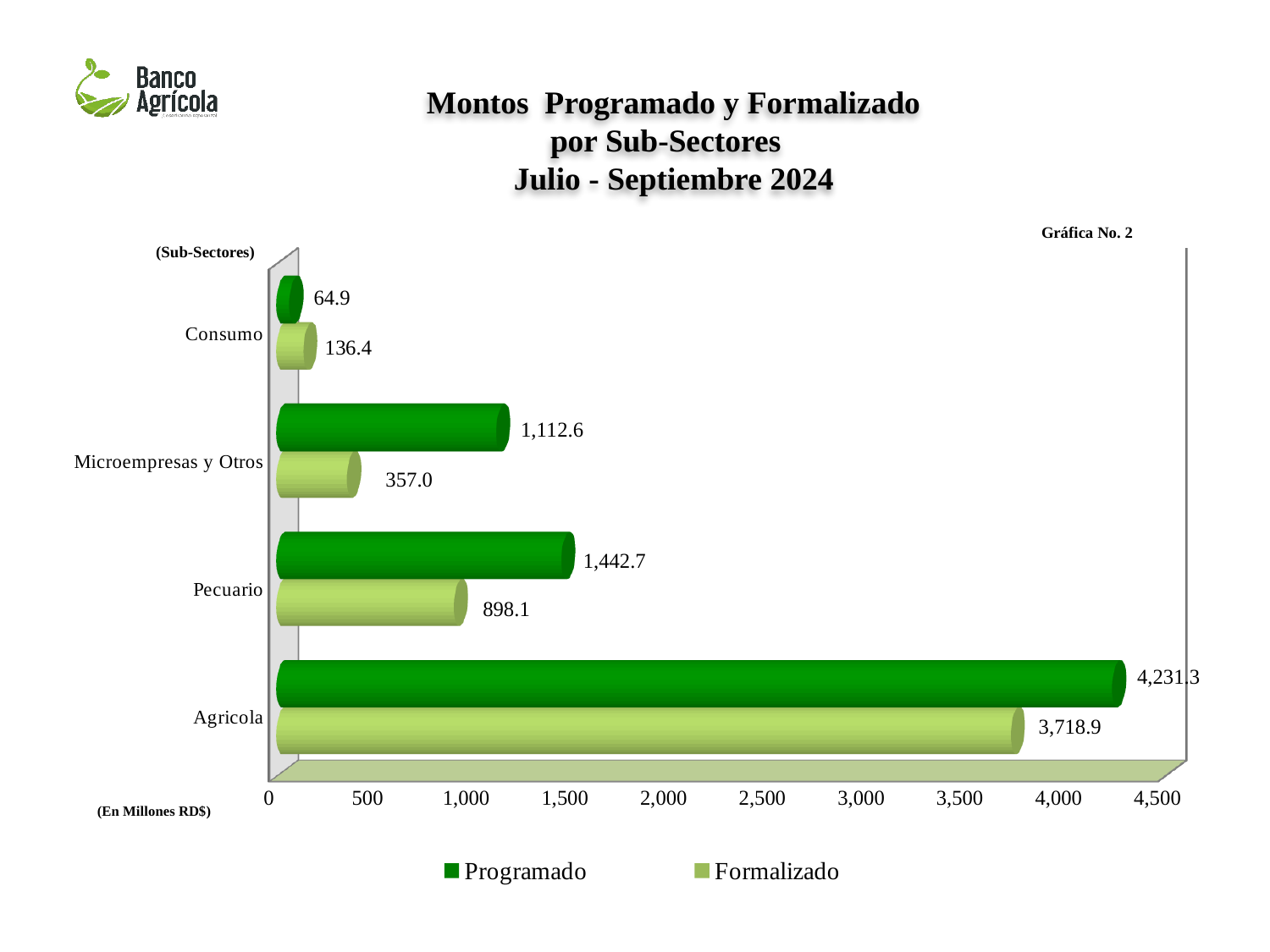
What is the Formalizado value for Microempresas y Otros? 357.0 What is the Formalizado value for Pecuario? 898.1 What is the Programado value for Consumo? 64.9 For Consumo, which is larger: the Programado value or the Formalizado value? Formalizado How many sub-sectors are shown on the chart? 4 What is the difference between the Programado and Formalizado values for Agricola? 512.4 What is the difference between the Programado and Formalizado values for Microempresas y Otros? 755.6 Which sub-sector has the highest Programado value? Agricola How many series does the legend list? 2 What kind of chart is shown on the slide? Bar chart What is the Programado value for Agricola? 4,231.3 Which sub-sector has the lowest Formalizado value? Consumo